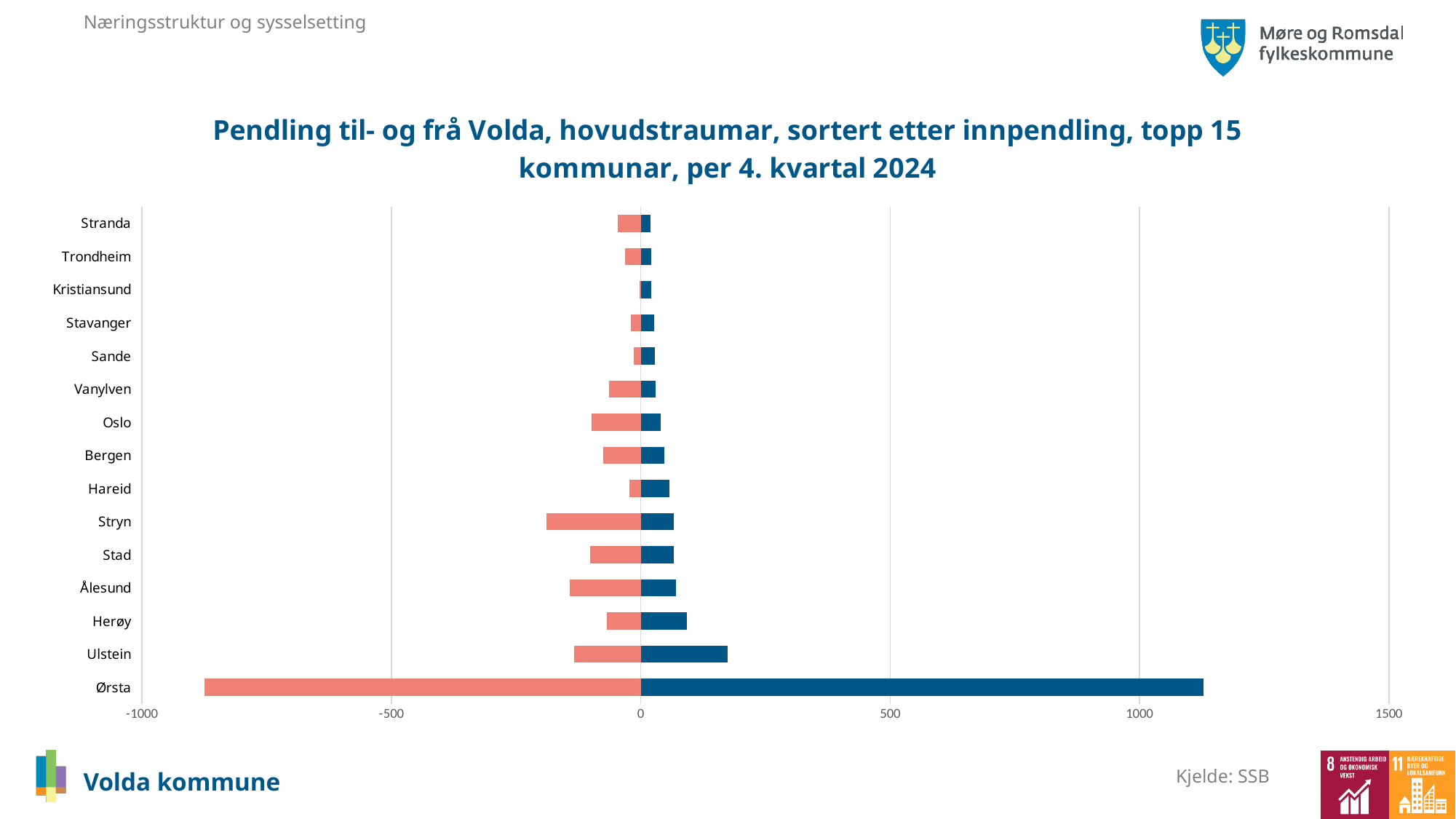
Is the value of the blue bar for Ørsta greater or less than 1000? greater What kind of chart is shown on the slide? bar chart How many municipalities (categories) are listed on the chart? 15 Which municipality has the second-longest blue bar after Ørsta? Ulstein Which has the longer red bar, Stryn or Stad? Stryn Is the value of the blue bar for Ulstein greater or less than 500? less Which municipality has the longest red bar (largest utpendling)? Ørsta What is the highest value shown on the horizontal axis? 1500 Which has the longer blue bar, Ulstein or Herøy? Ulstein What is the title of the chart? Pendling til- og frå Volda, hovudstraumar, sortert etter innpendling, topp 15 kommunar, per 4. kvartal 2024 Is the value of the red bar for Ørsta greater or less than -500? less Which municipality has the longest blue bar (highest innpendling)? Ørsta